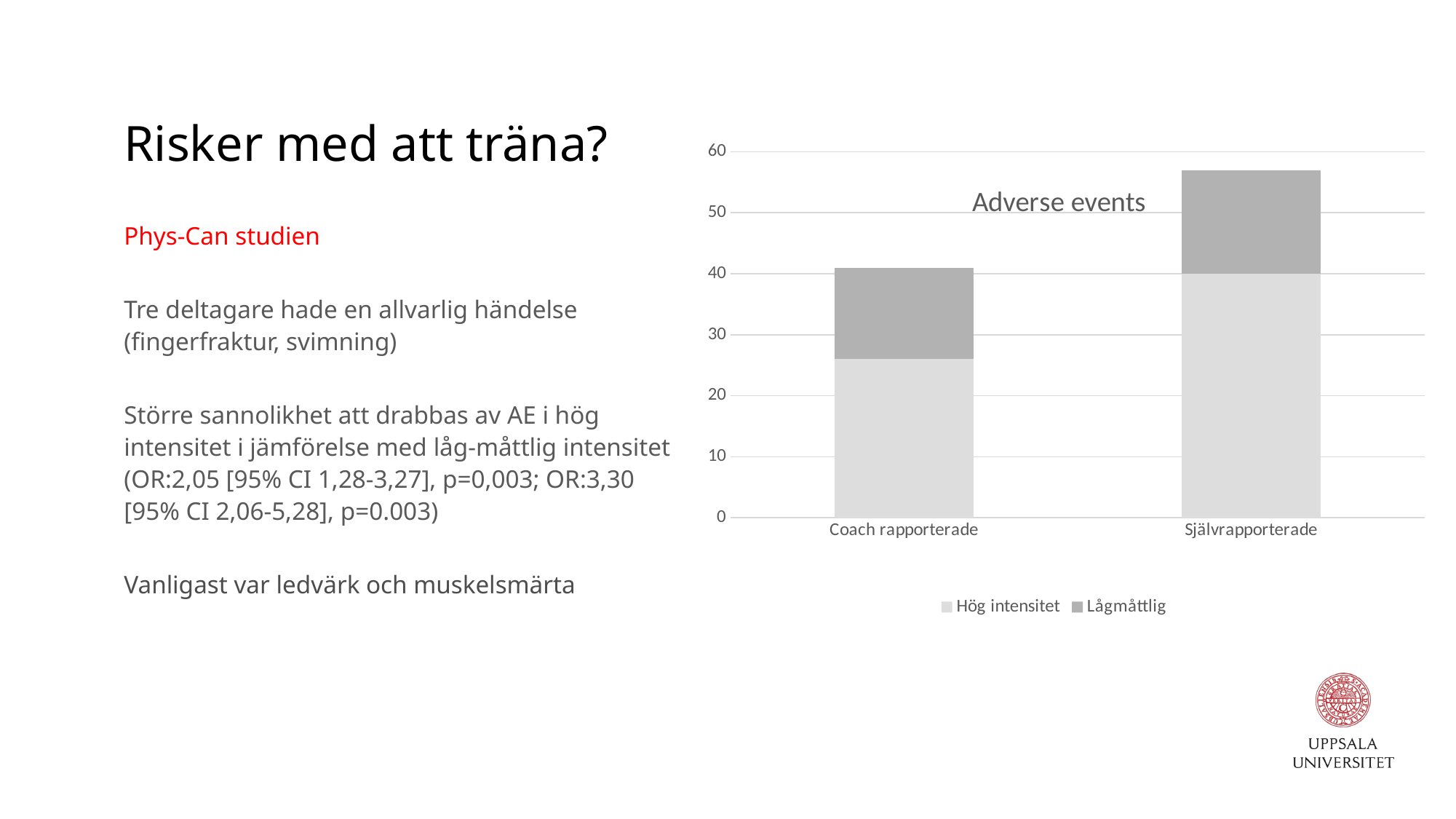
Which category has the highest total of adverse events? Självrapporterade Which category has the larger Hög intensitet value, Coach rapporterade or Självrapporterade? Självrapporterade Which series are listed in the chart legend? Hög intensitet, Lågmåttlig Which category has the taller stacked bar, Coach rapporterade or Självrapporterade? Självrapporterade What kind of chart is shown on the slide? stacked bar chart How many series does the chart legend list? 2 Is the total height of the Självrapporterade bar greater or less than 50? greater What is the title of the chart? Adverse events How many categories are shown on the x axis of the chart? 2 Is the Hög intensitet value for Coach rapporterade greater or less than 20? greater Which category has the lowest total of adverse events? Coach rapporterade Is the Hög intensitet value for Coach rapporterade greater or less than 30? less